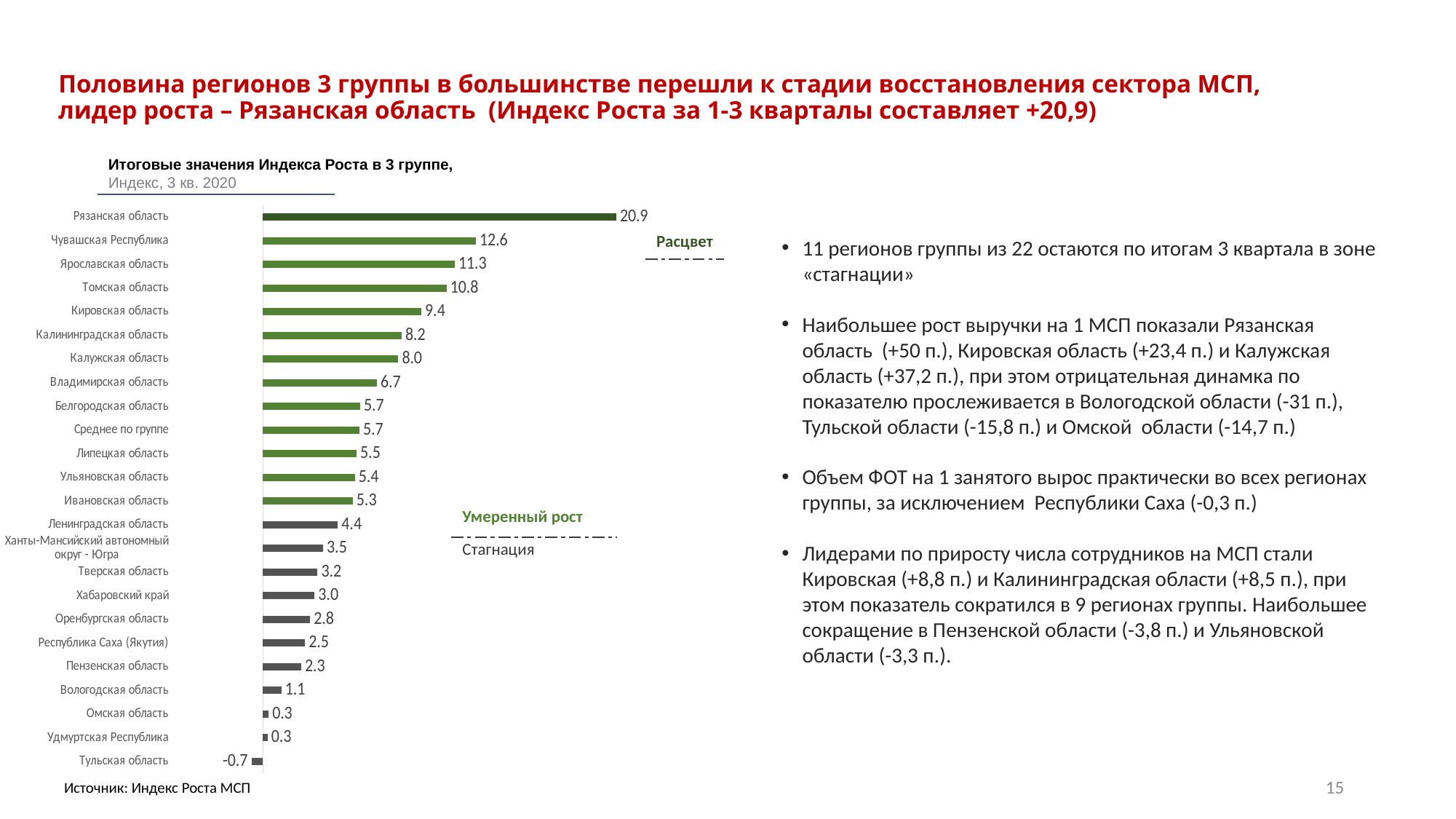
What type of chart is shown on the slide? Bar chart What is the title of the chart? Итоговые значения Индекса Роста в 3 группе What is the difference between the values for Рязанская область and Чувашская Республика? 8.3 What is the value for Кировская область? 9.4 Which has a larger value, Калужская область or Владимирская область? Калужская область Which region has the lowest value on the chart? Тульская область What is the value for Рязанская область? 20.9 How many bars are plotted on the chart? 24 Which region has the highest value on the chart? Рязанская область What is the value for Тульская область? -0.7 What is the value for Среднее по группе? 5.7 What is the value for Вологодская область? 1.1